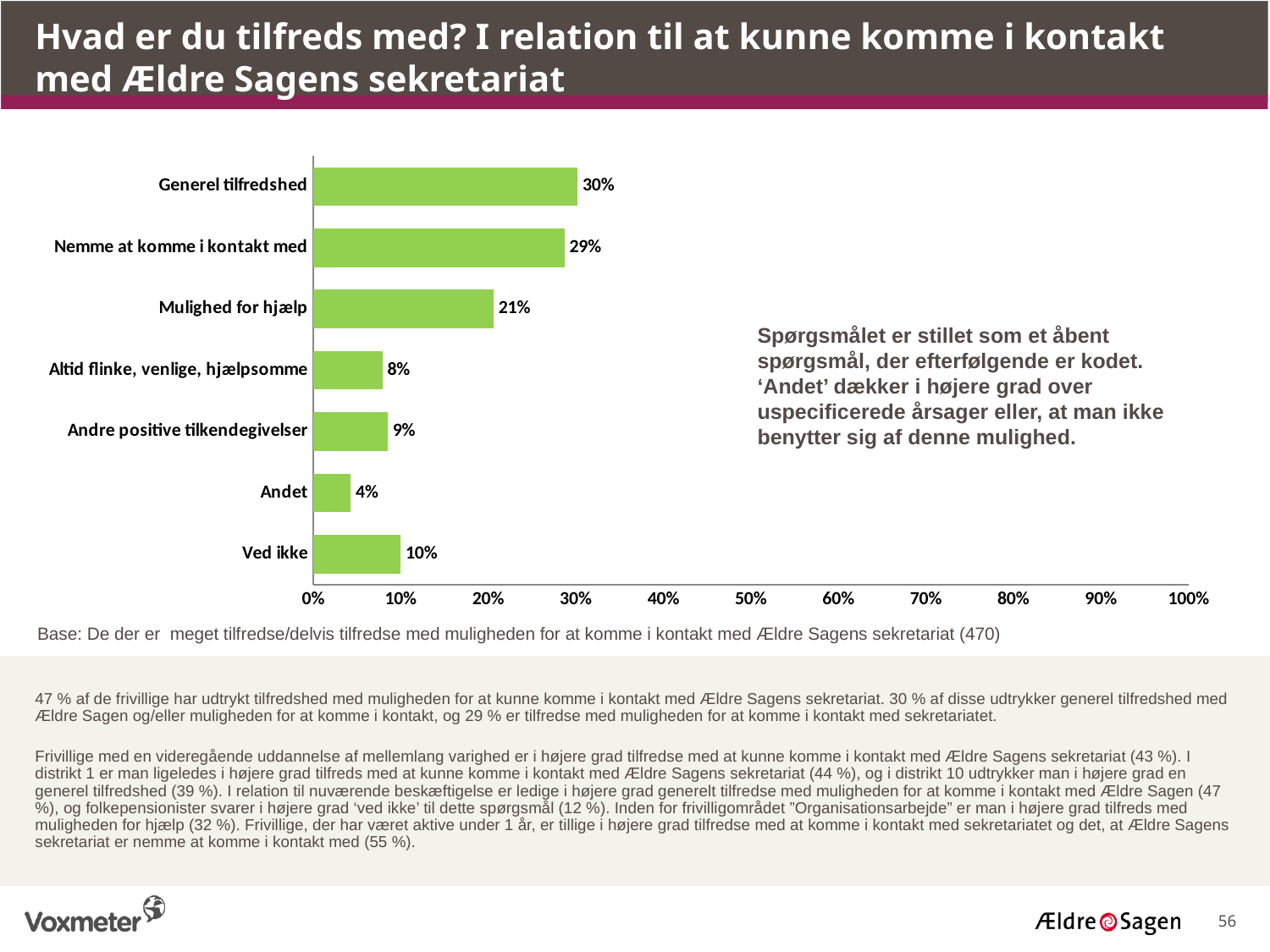
Which is larger, 'Altid flinke, venlige, hjælpsomme' or 'Andre positive tilkendegivelser'? Andre positive tilkendegivelser Which category has the highest value? Generel tilfredshed What colour are the bars in the chart? Green Is the value for 'Nemme at komme i kontakt med' greater or less than 20%? greater What is the difference between 'Nemme at komme i kontakt med' and 'Mulighed for hjælp'? 8 percentage points Which category has the lowest value? Andet What is the value for 'Generel tilfredshed'? 30% What kind of chart is shown on the slide? Bar chart How many categories are shown in the chart? 7 What is the maximum value shown on the x axis? 100% What is the value for 'Ved ikke'? 10% What is the value for 'Mulighed for hjælp'? 21%